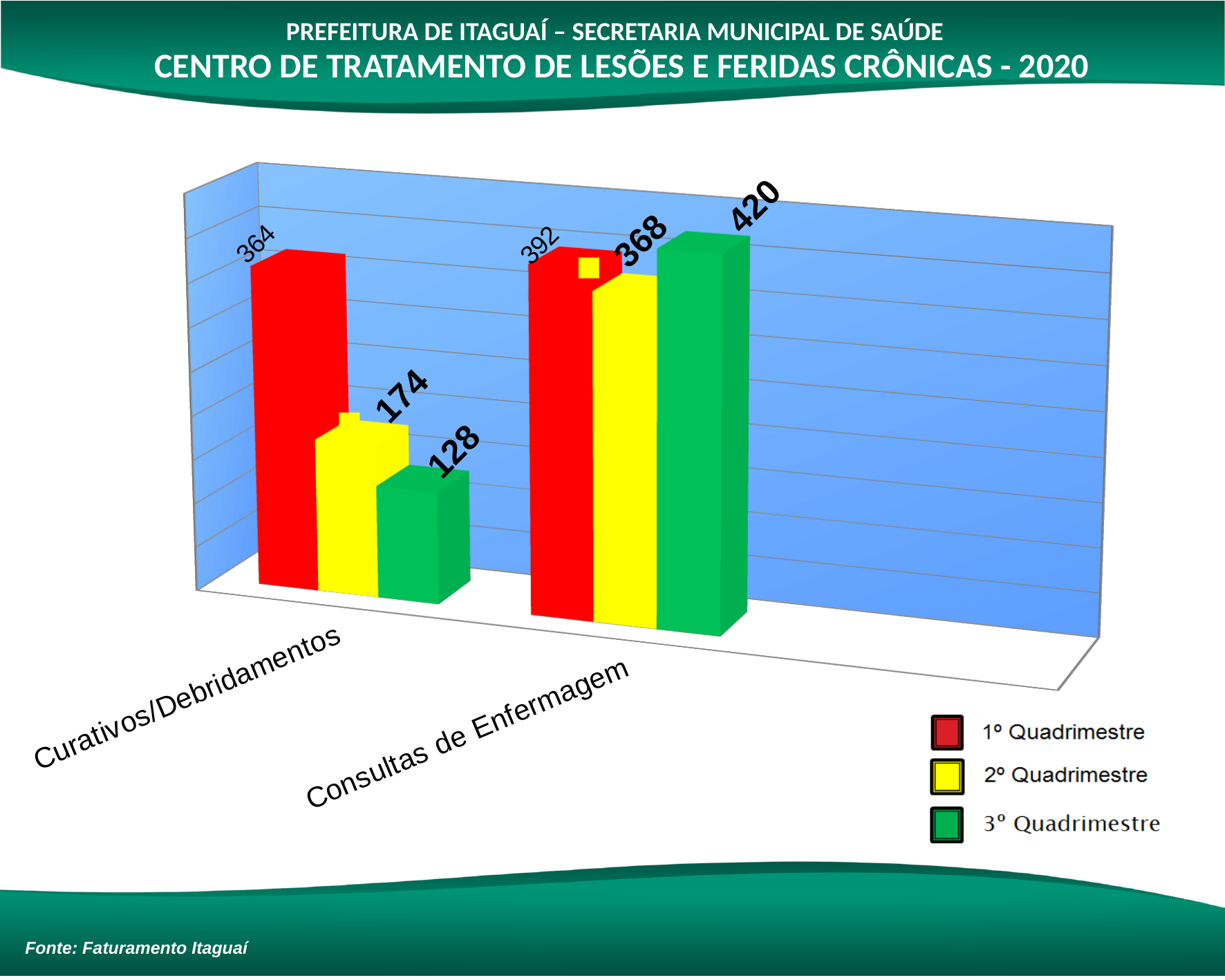
What is the difference between the 1º Quadrimestre and 3º Quadrimestre values for Curativos/Debridamentos? 236 Which quadrimestre has the highest value for Consultas de Enfermagem? 3º Quadrimestre What is the value for Consultas de Enfermagem in the 3º Quadrimestre? 420 Which quadrimestre has the lowest value for Curativos/Debridamentos? 3º Quadrimestre What kind of chart is shown on the slide? Bar chart What is the difference between the 3º Quadrimestre and 2º Quadrimestre values for Consultas de Enfermagem? 52 What is the value for Consultas de Enfermagem in the 2º Quadrimestre? 368 How many series does the legend list? 3 Which is larger: the 1º Quadrimestre value for Curativos/Debridamentos or the 1º Quadrimestre value for Consultas de Enfermagem? Consultas de Enfermagem How many categories are shown on the x axis of the chart? 2 What is the value for Curativos/Debridamentos in the 1º Quadrimestre? 364 What is the value for Curativos/Debridamentos in the 2º Quadrimestre? 174